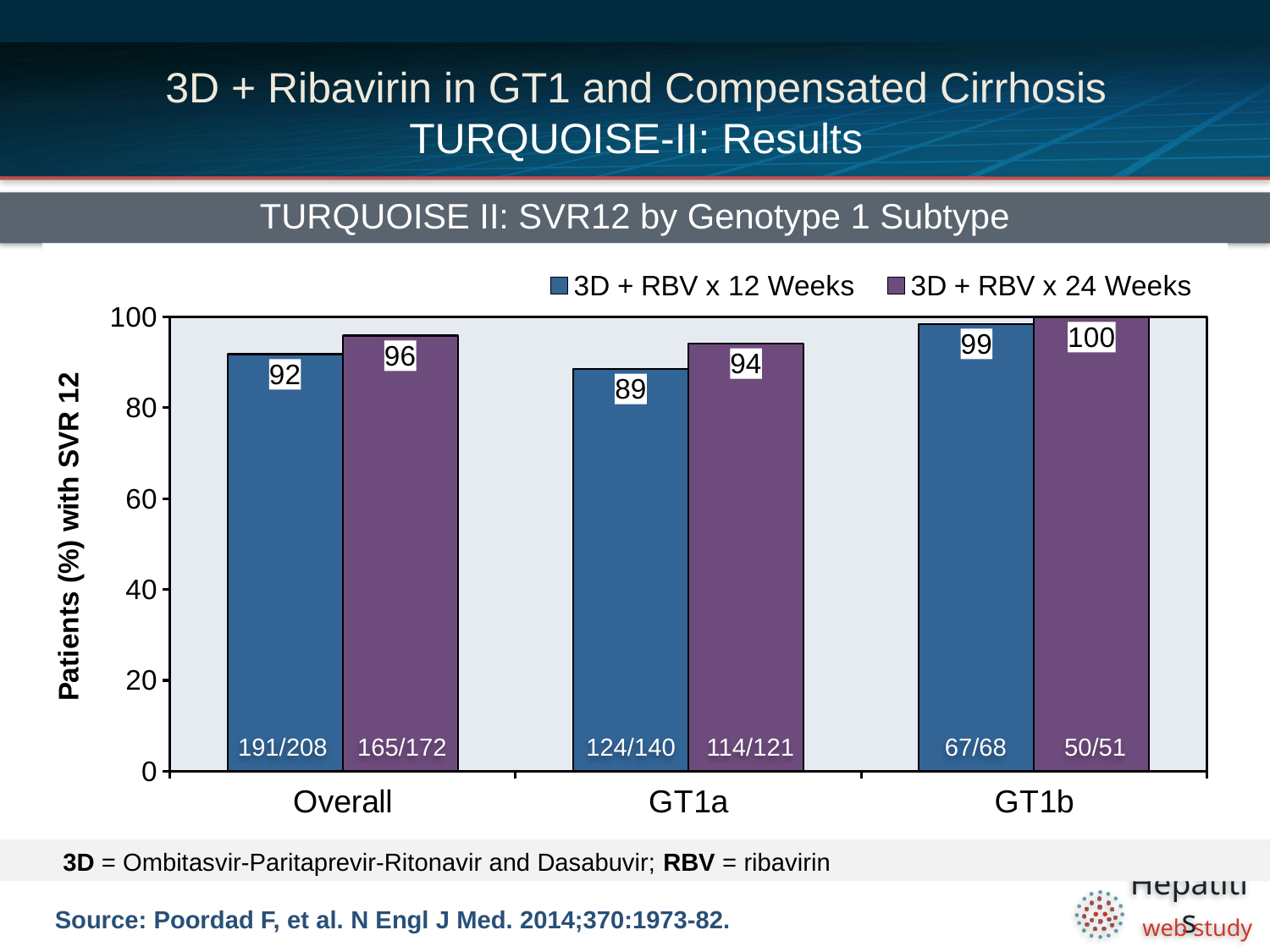
What fraction of patients is shown for 3D + RBV x 12 Weeks in the GT1a group? 124/140 How many series does the legend list? 2 Which category has the lowest SVR12 rate for 3D + RBV x 12 Weeks? GT1a What kind of chart is shown on the slide? Bar chart Which is larger in the Overall group: the 12-week or the 24-week SVR12 rate? 3D + RBV x 24 Weeks Which genotype subtype has the highest SVR12 rate for 3D + RBV x 24 Weeks? GT1b What is the SVR12 rate for 3D + RBV x 12 Weeks in the Overall group? 92 What is the difference between the 24-week and 12-week SVR12 rates in the GT1a group? 5 What is the label of the y axis? Patients (%) with SVR 12 What is the SVR12 rate for 3D + RBV x 12 Weeks in the GT1b group? 99 What is the SVR12 rate for 3D + RBV x 24 Weeks in the GT1a group? 94 How many genotype categories are shown on the x axis? 3